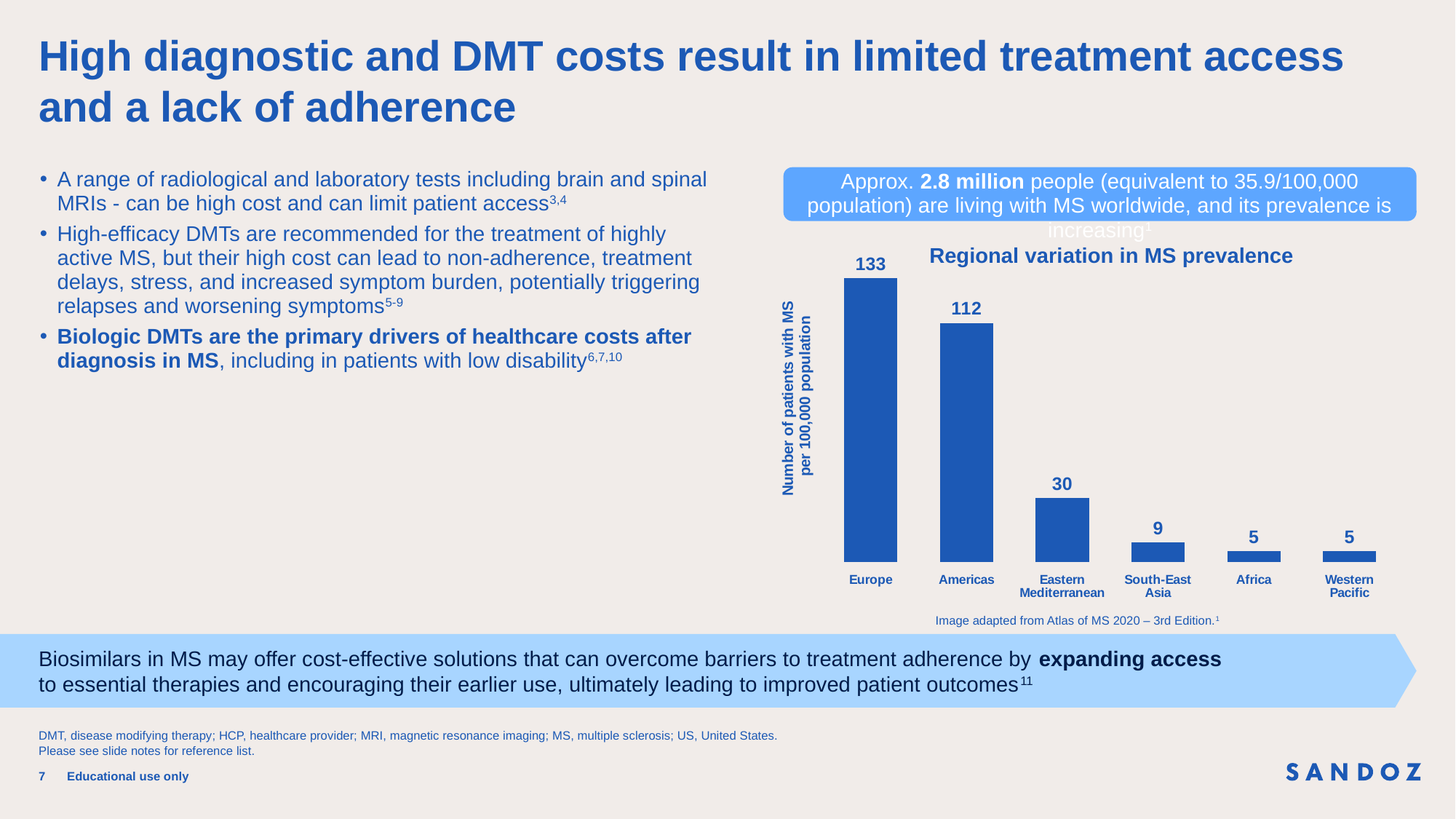
What is the title of the chart on the slide? Regional variation in MS prevalence Which is larger, the value for the Americas or the value for Eastern Mediterranean? Americas What is the value for South-East Asia in the chart? 9 What is the value for the Americas in the chart? 112 What is the difference between the values for Europe and the Americas? 21 Do the values rise or fall from left to right across the regions in the chart? Fall What kind of chart is shown on the slide? Bar chart What is the value for Eastern Mediterranean in the chart? 30 How many regions are shown in the chart? 6 What is the difference between the values for Eastern Mediterranean and South-East Asia? 21 What is the value for Europe in the Regional variation in MS prevalence chart? 133 Which region has the highest MS prevalence in the chart? Europe